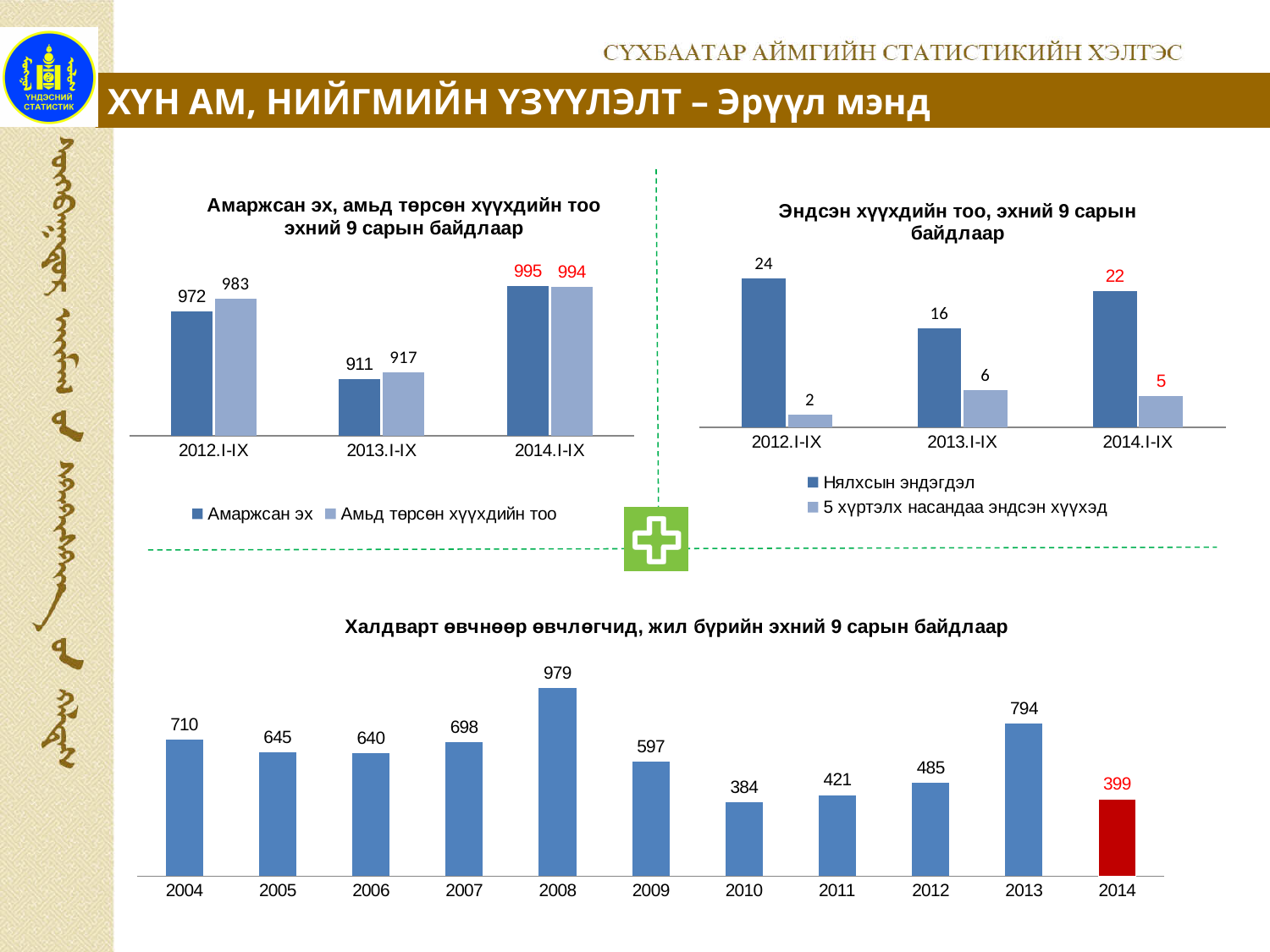
In the top-left chart (Амаржсан эх, амьд төрсөн хүүхдийн тоо), how many series does the legend list? 2 In the bottom chart (Халдварт өвчнөөр өвчлөгчид), is the value for 2013 larger or smaller than the value for 2014? larger In the top-right chart (Эндсэн хүүхдийн тоо), what is the value for Нялхсын эндэгдэл in 2013.I-IX? 16 In the top-left chart (Амаржсан эх, амьд төрсөн хүүхдийн тоо), what is the value for Амаржсан эх in 2013.I-IX? 911 In the top-right chart (Эндсэн хүүхдийн тоо), which period has the highest value for Нялхсын эндэгдэл? 2012.I-IX In the bottom chart (Халдварт өвчнөөр өвчлөгчид), which year has the lowest value? 2010 In the top-left chart (Амаржсан эх, амьд төрсөн хүүхдийн тоо), what is the value for Амьд төрсөн хүүхдийн тоо in 2014.I-IX? 994 In the top-right chart (Эндсэн хүүхдийн тоо), what is the difference between Нялхсын эндэгдэл and 5 хүртэлх насандаа эндсэн хүүхэд in 2014.I-IX? 17 In the top-right chart (Эндсэн хүүхдийн тоо), which period has the lowest value for 5 хүртэлх насандаа эндсэн хүүхэд? 2012.I-IX In the top-left chart (Амаржсан эх, амьд төрсөн хүүхдийн тоо), what is the difference between Амьд төрсөн хүүхдийн тоо and Амаржсан эх in 2012.I-IX? 11 In the bottom chart (Халдварт өвчнөөр өвчлөгчид), how many years are shown on the x axis? 11 In the bottom chart (Халдварт өвчнөөр өвчлөгчид), which year has the highest value? 2008